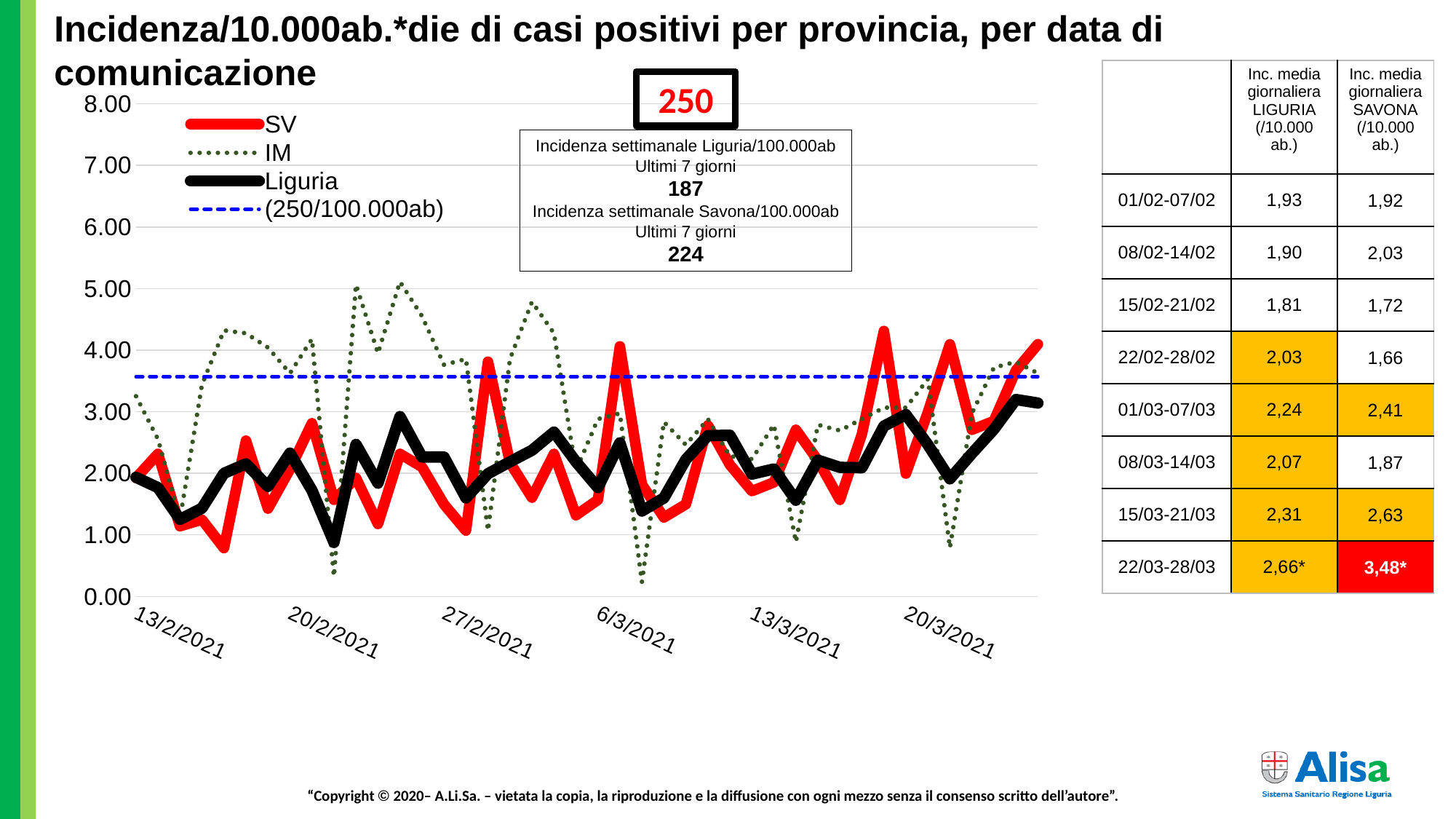
How many series does the chart legend list? 4 What kind of chart is shown on the slide? line chart What is the highest value shown on the y axis? 8.00 Is the value of the SV series at 6/3/2021 greater or less than 3.00? less What does the dashed blue horizontal line represent according to the legend? (250/100.000ab) Is the value of the IM series at 13/2/2021 greater or less than 3.00? greater How many date labels are shown on the x axis? 6 Which series is drawn as a dotted green line? IM At 13/2/2021, which series has the larger value, SV or IM? IM Does the Liguria series rise or fall overall between 13/3/2021 and the end of the chart? rise At 27/2/2021, which series has the larger value, SV or Liguria? Liguria Is the value of the Liguria series at 20/2/2021 greater or less than 1.00? greater